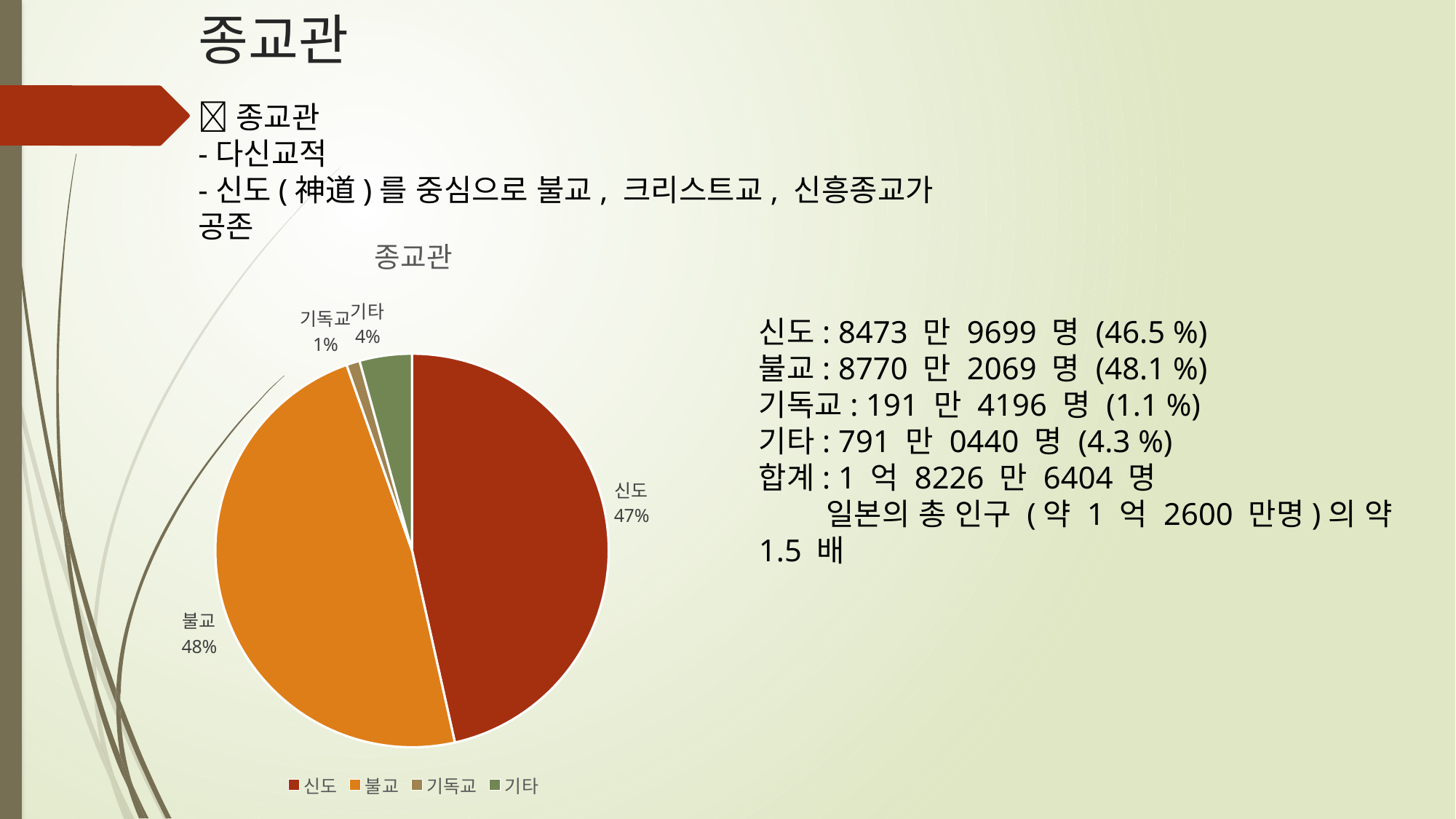
How many entries does the chart legend list? 4 What percentage is shown for 기독교 in the pie chart? 1% How many categories are shown in the pie chart? 4 What is the title of the chart? 종교관 What percentage is shown for 기타 in the pie chart? 4% Which category has the largest slice of the pie? 불교 What is the difference in percentage points between 기타 and 기독교? 3 Which slice is larger, 신도 or 기타? 신도 What percentage of the pie does 불교 account for? 48% What kind of chart is shown on the slide? pie chart What percentage of the pie does 신도 account for? 47% Which category has the smallest slice of the pie? 기독교